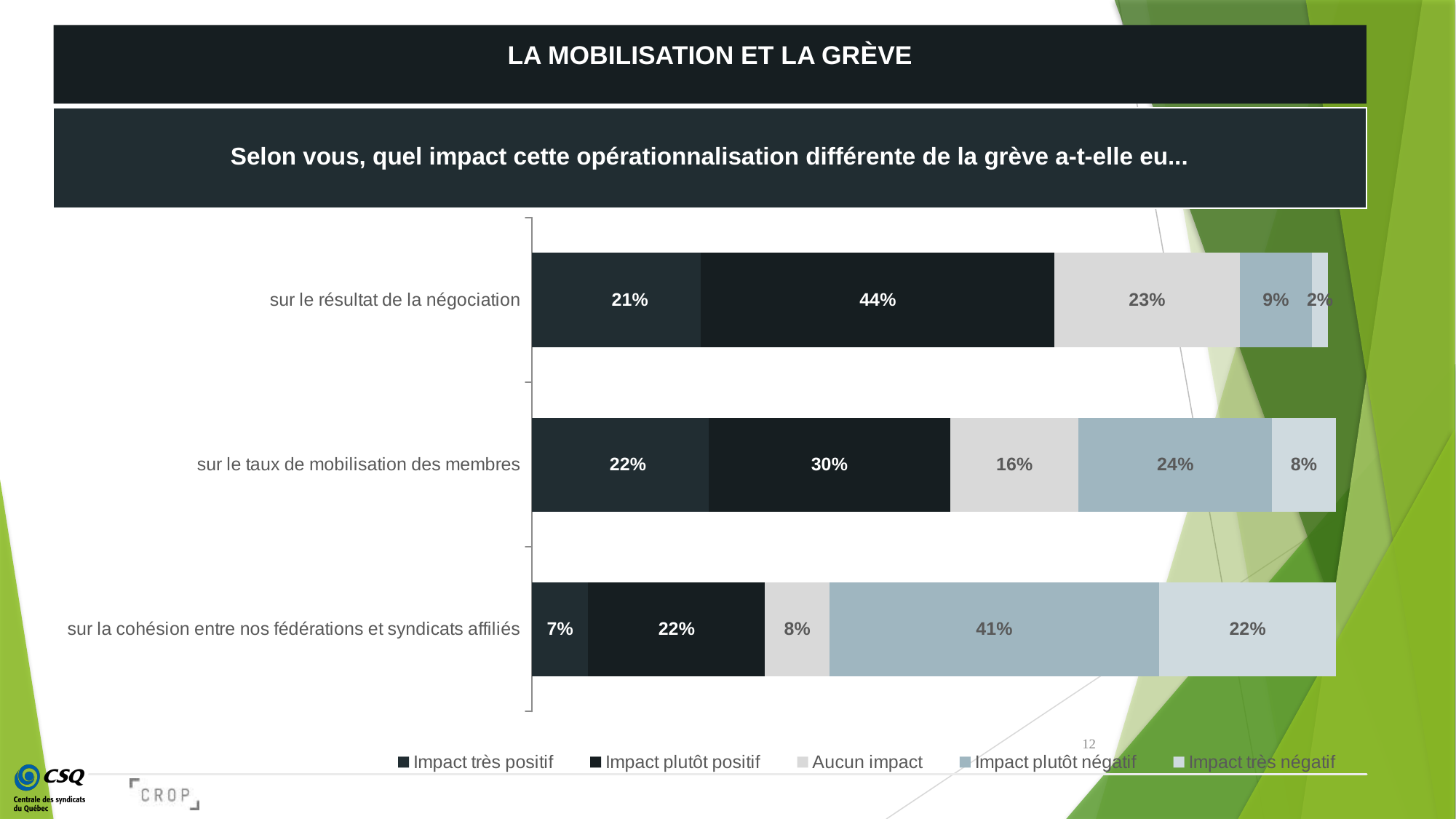
Which category has the lowest value for "Impact plutôt négatif"? sur le résultat de la négociation How many series does the legend list? 5 What is the value of "Impact très négatif" for "sur le résultat de la négociation"? 2% What is the total of the stacked bar for "sur le taux de mobilisation des membres"? 100% What is the value of "Aucun impact" for "sur le taux de mobilisation des membres"? 16% What is the value of "Impact plutôt négatif" for "sur la cohésion entre nos fédérations et syndicats affiliés"? 41% How many categories are plotted on the chart? 3 What kind of chart is shown on the slide? stacked bar chart What is the difference between "Impact plutôt positif" for "sur le résultat de la négociation" and for "sur le taux de mobilisation des membres"? 14% Which category has the highest value for "Impact très positif"? sur le taux de mobilisation des membres Which is larger: "Impact très négatif" for "sur le taux de mobilisation des membres" or for "sur la cohésion entre nos fédérations et syndicats affiliés"? sur la cohésion entre nos fédérations et syndicats affiliés What is the value of "Impact plutôt positif" for "sur le résultat de la négociation"? 44%